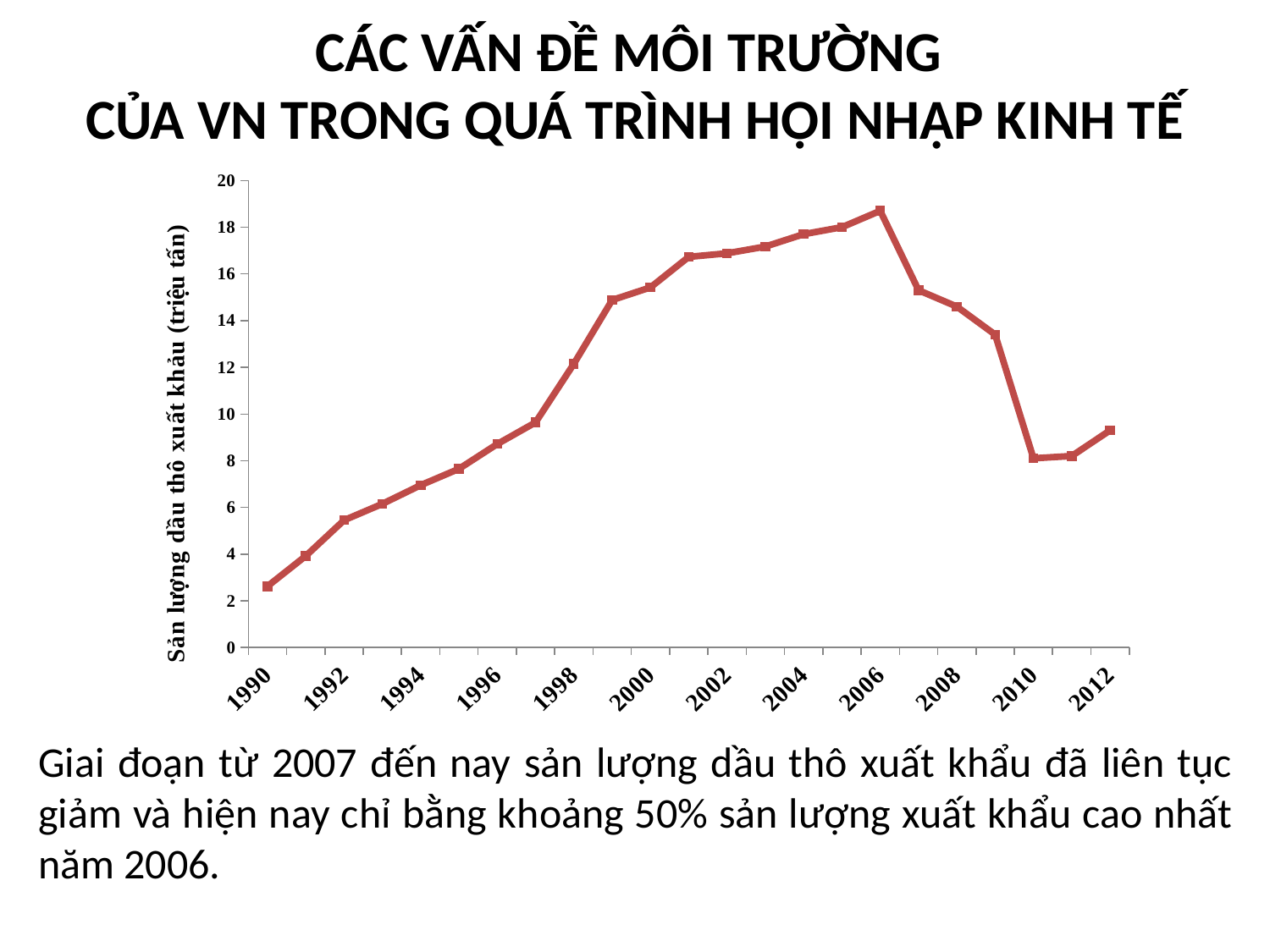
Is the value for 2006 greater or less than 18? greater Is the value for 2008 greater or less than 16? less Which year has the larger crude oil export volume, 2006 or 2010? 2006 In which year does the crude oil export volume reach its highest point? 2006 In which year is the crude oil export volume lowest? 1990 Is the value for 2000 greater or less than 14? greater Does the crude oil export volume rise or fall between 1990 and 2006? rise What is the label on the vertical axis of the chart? Sản lượng dầu thô xuất khẩu (triệu tấn) What kind of chart is shown on the slide? line chart Does the crude oil export volume rise or fall between 2006 and 2010? fall